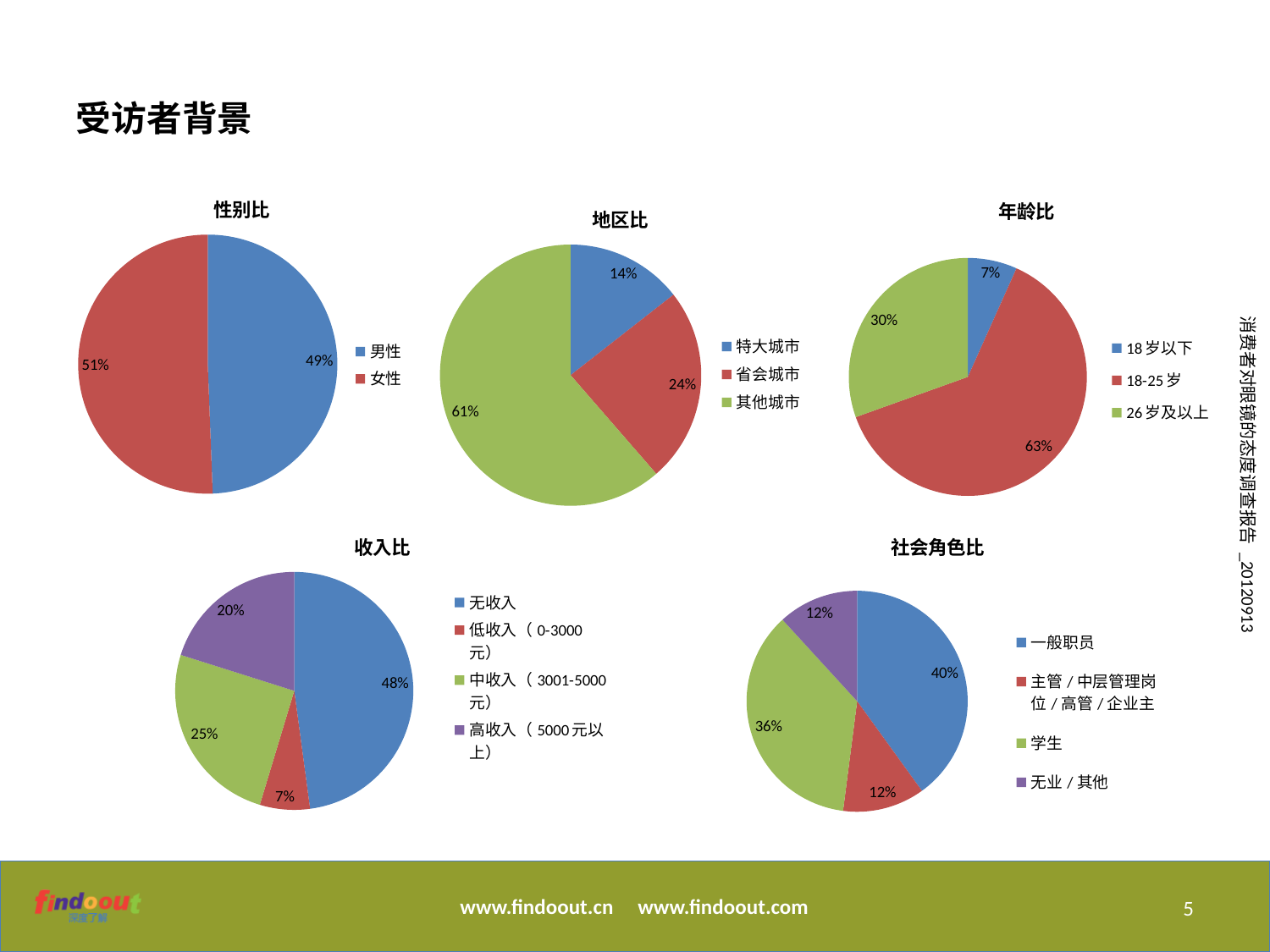
In the 地区比 chart, what is the value for 省会城市? 24% In the 年龄比 chart, what is the difference between the shares of 18-25 岁 and 26 岁及以上? 33% In the 性别比 chart, what share of respondents are 女性? 51% What type of chart is the 地区比 chart? Pie chart In the 年龄比 chart, which category has the smallest share? 18 岁以下 In the 地区比 chart, which category has the largest share? 其他城市 How many charts are shown on the slide? 5 In the 社会角色比 chart, what share of respondents are 学生? 36% In the 收入比 chart, which is larger, 高收入 (5000 元以上) or 低收入 (0-3000 元)? 高收入 (5000 元以上) In the 社会角色比 chart, which category has the largest share? 一般职员 In the 收入比 chart, what is the value for 中收入 (3001-5000 元)? 25% In the 收入比 chart, how many categories does the legend list? 4